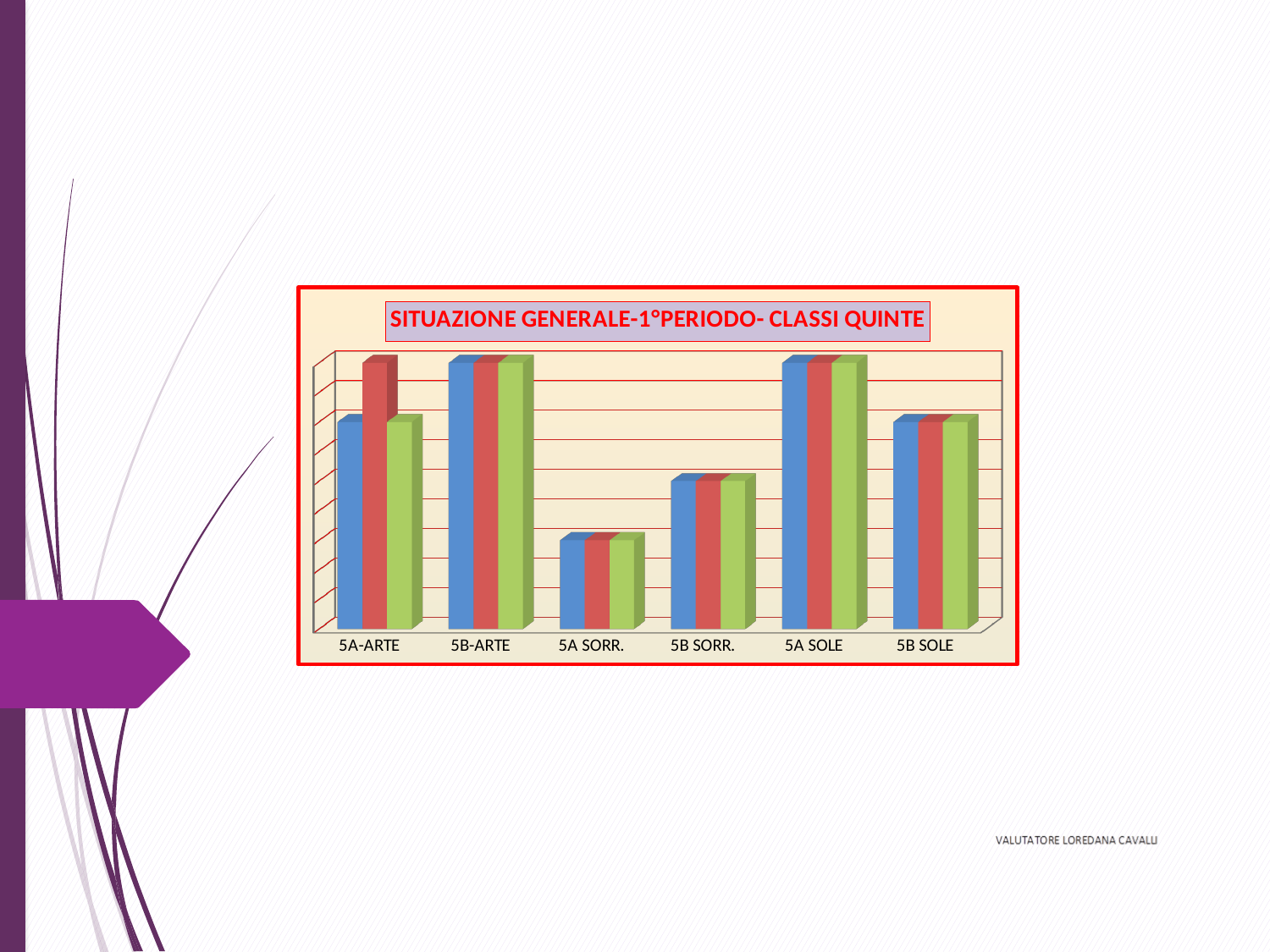
Which category has taller bars, 5B-ARTE or 5B SOLE? 5B-ARTE Do the bar heights rise steadily from left to right across the categories? No Which category has taller bars, 5B SORR. or 5B SOLE? 5B SOLE How many categories are shown on the x axis of the chart? 6 What colours are the three bars in each category of the chart? blue, red and green Which category has the lowest bars in the chart? 5A SORR. What is the title of the chart? SITUAZIONE GENERALE-1°PERIODO- CLASSI QUINTE Which category has taller bars, 5A SORR. or 5B SORR.? 5B SORR. What kind of chart is shown on the slide? bar chart How many bars are plotted for each category in the chart? 3